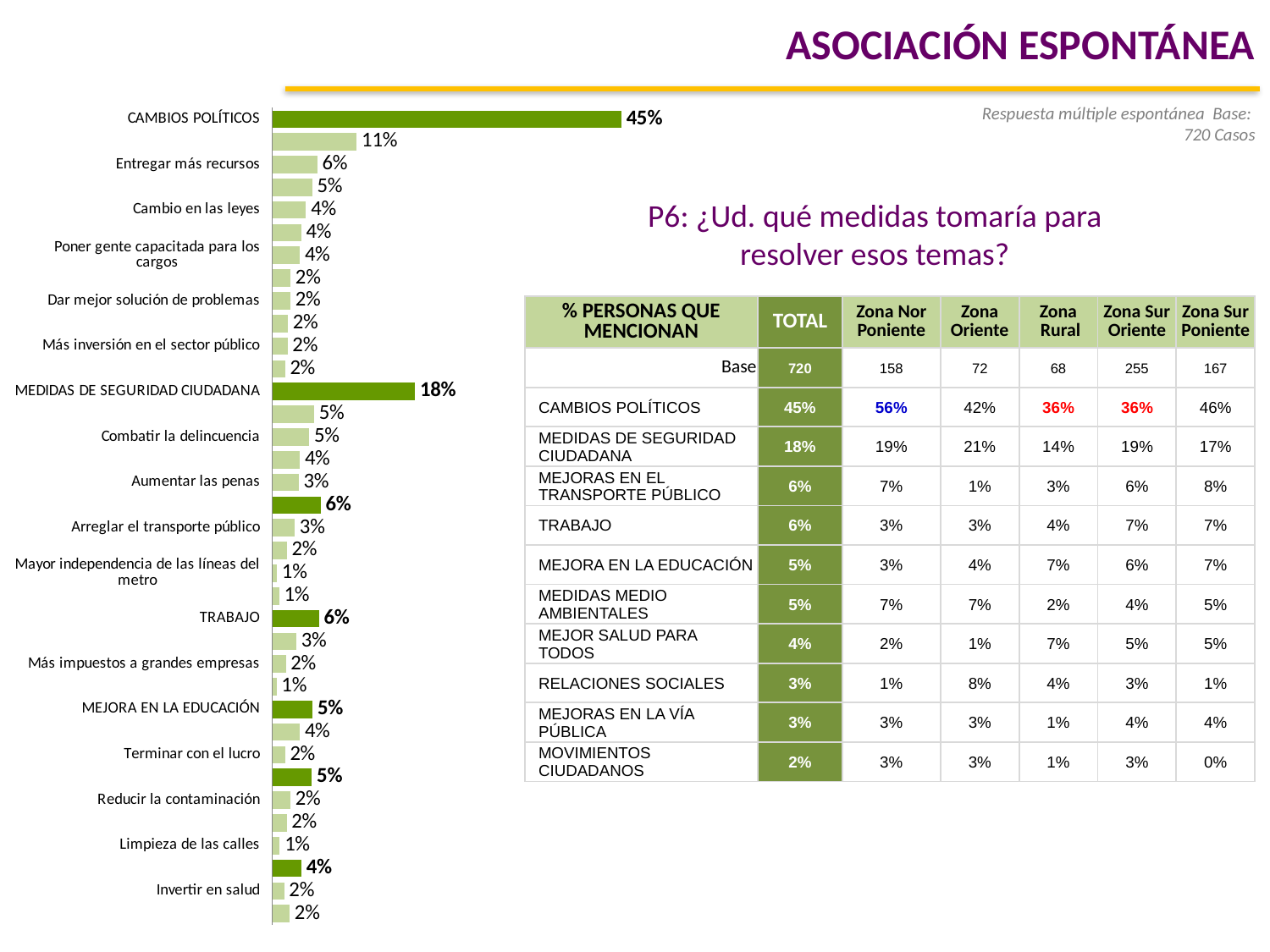
What kind of chart is shown on the left of the slide? Bar chart What is the value for MEDIDAS DE SEGURIDAD CIUDADANA in the bar chart? 18% Which category has the highest value in the bar chart? CAMBIOS POLÍTICOS Which is larger in the bar chart, the value for Entregar más recursos or the value for Cambio en las leyes? Entregar más recursos What is the value for Mayor independencia de las líneas del metro in the bar chart? 1% What is the difference between the values for CAMBIOS POLÍTICOS and MEDIDAS DE SEGURIDAD CIUDADANA in the bar chart? 27% What is the value for CAMBIOS POLÍTICOS in the bar chart? 45% What is the value for MEJORA EN LA EDUCACIÓN in the bar chart? 5% What is the difference between the values for TRABAJO and Aumentar las penas in the bar chart? 3% What is the value for Combatir la delincuencia in the bar chart? 5% What is the value for TRABAJO in the bar chart? 6% What is the value for Limpieza de las calles in the bar chart? 1%